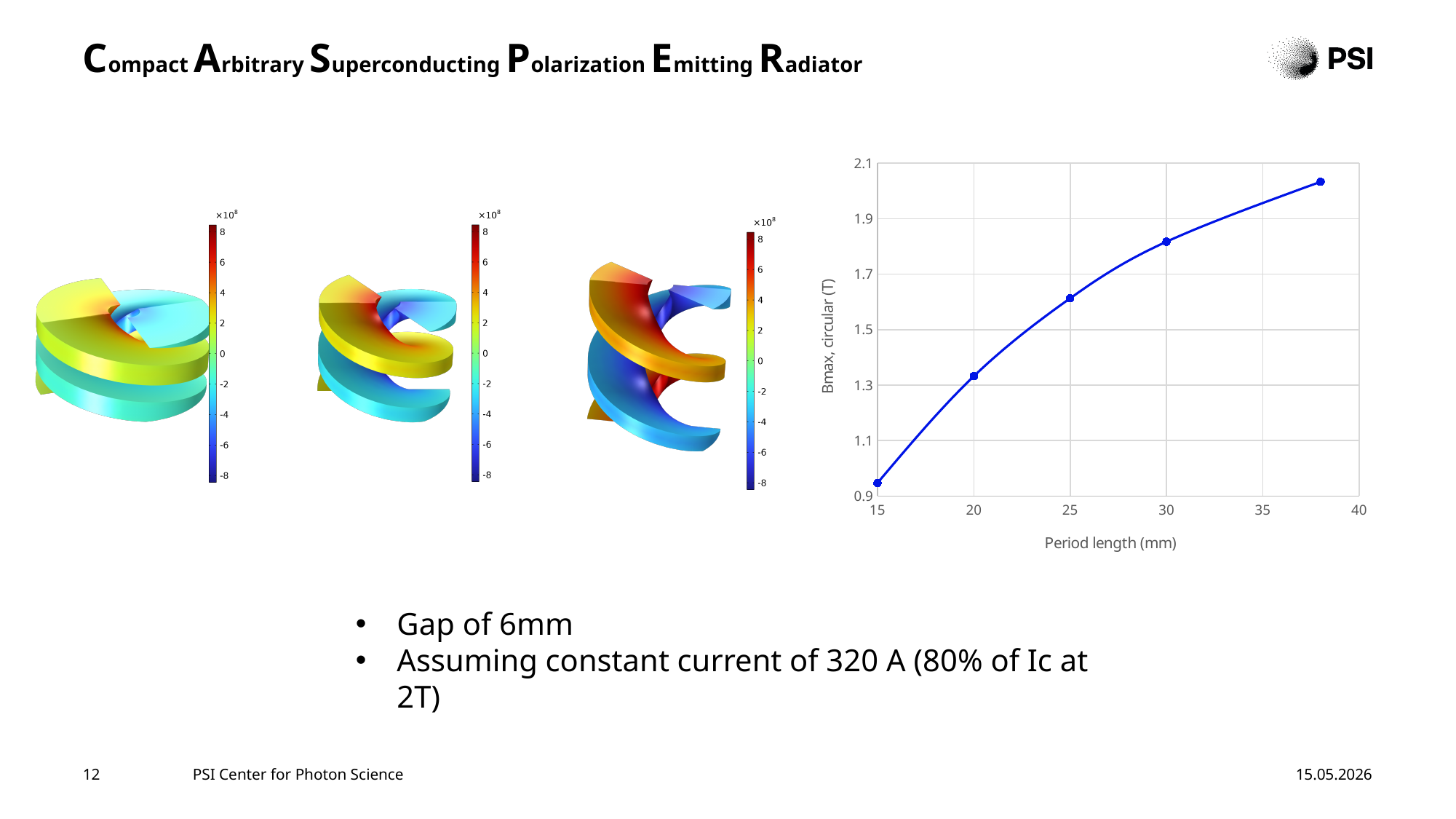
What kind of chart is shown on the right of the slide? line chart In the line chart on the right, is the value of Bmax at a period length of 25 mm greater or less than 1.5? greater In the line chart on the right, which has the larger Bmax: a period length of 20 mm or 30 mm? 30 mm In the line chart on the right, is the value of Bmax at a period length of 20 mm greater or less than 1.5? less What is the label of the x axis of the line chart on the right? Period length (mm) In the line chart on the right, at which period length is Bmax lowest? 15 mm In the line chart on the right, does Bmax rise or fall as the period length increases? rises In the line chart on the right, is the value of Bmax at a period length of 15 mm greater or less than 1.1? less In the line chart on the right, how many data points are plotted? 5